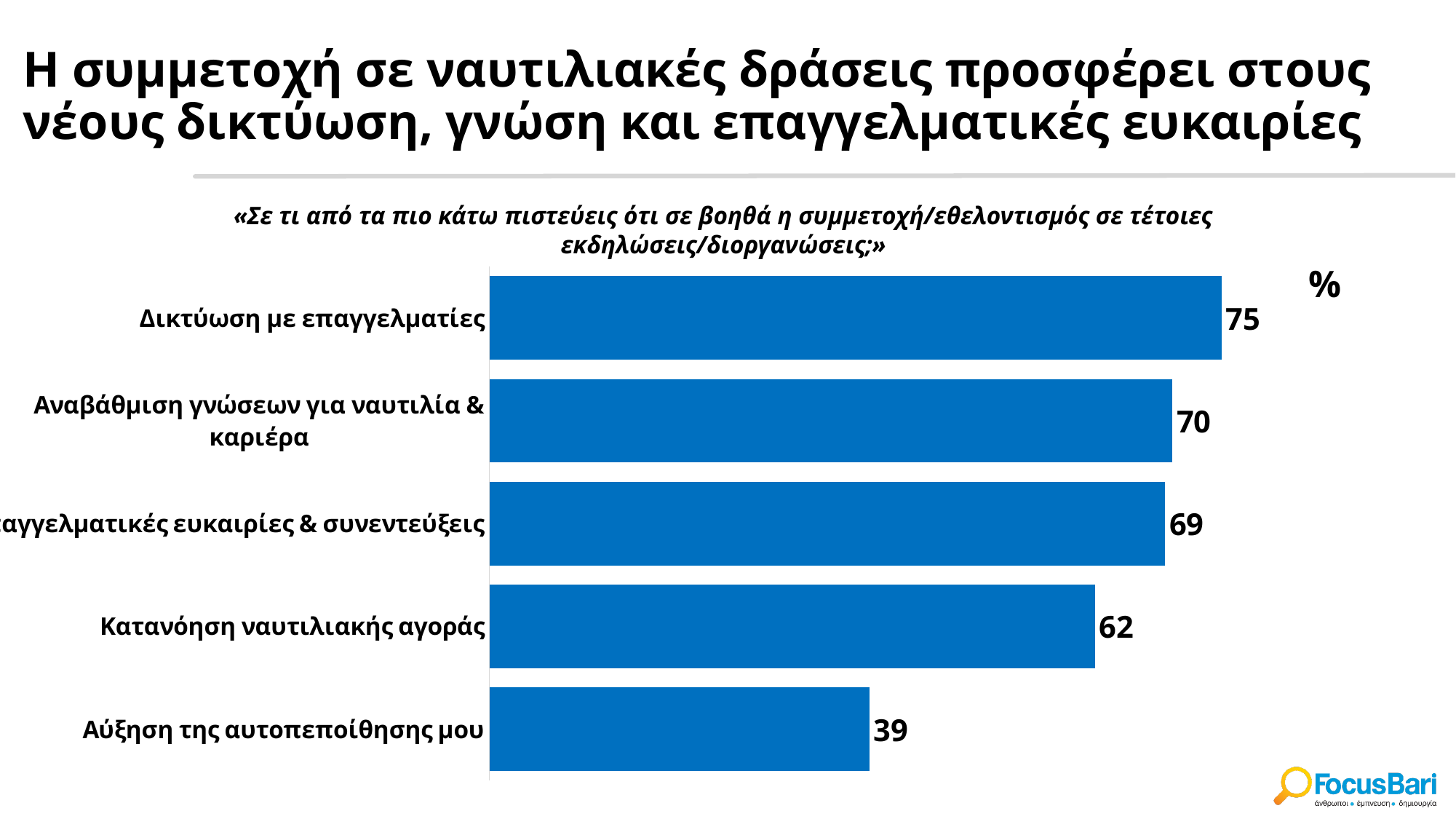
What is the difference between the values for Αναβάθμιση γνώσεων για ναυτιλία & καριέρα and Κατανόηση ναυτιλιακής αγοράς? 8 What value is shown for Αναβάθμιση γνώσεων για ναυτιλία & καριέρα? 70 Which category has the lowest value? Αύξηση της αυτοπεποίθησης μου Which category has the highest value? Δικτύωση με επαγγελματίες What is the difference between the values for Δικτύωση με επαγγελματίες and Αύξηση της αυτοπεποίθησης μου? 36 What value is shown for Κατανόηση ναυτιλιακής αγοράς? 62 Which is larger, the value for Κατανόηση ναυτιλιακής αγοράς or the value for Αύξηση της αυτοπεποίθησης μου? Κατανόηση ναυτιλιακής αγοράς What value is shown for Δικτύωση με επαγγελματίες? 75 What value is shown for Αύξηση της αυτοπεποίθησης μου? 39 What value is shown for the third bar from the top? 69 How many categories are shown in the chart? 5 What kind of chart is shown on the slide? Bar chart